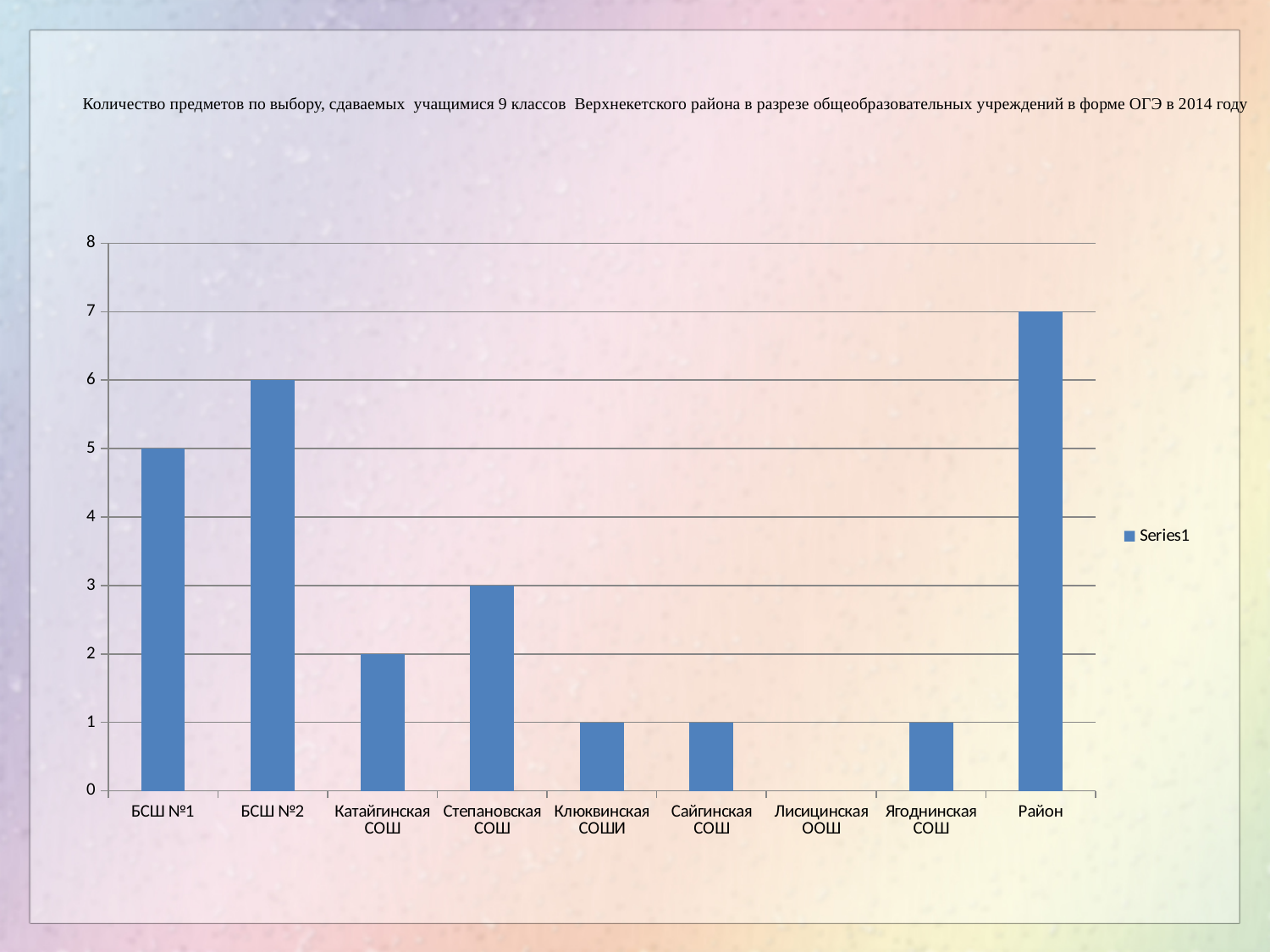
Which category has the lowest value? Лисицинская ООШ What is the value for Катайгинская СОШ? 2 Which is larger, the value for БСШ №1 or the value for Степановская СОШ? БСШ №1 What is the difference between the values for БСШ №2 and БСШ №1? 1 What is the value for Степановская СОШ? 3 How many categories are shown on the x axis? 9 What kind of chart is shown on the slide? Bar chart Which category has the highest value? Район What is the value for Район? 7 What is the value for БСШ №2? 6 Is the value for Район greater or less than 6? greater How many series does the legend list? 1